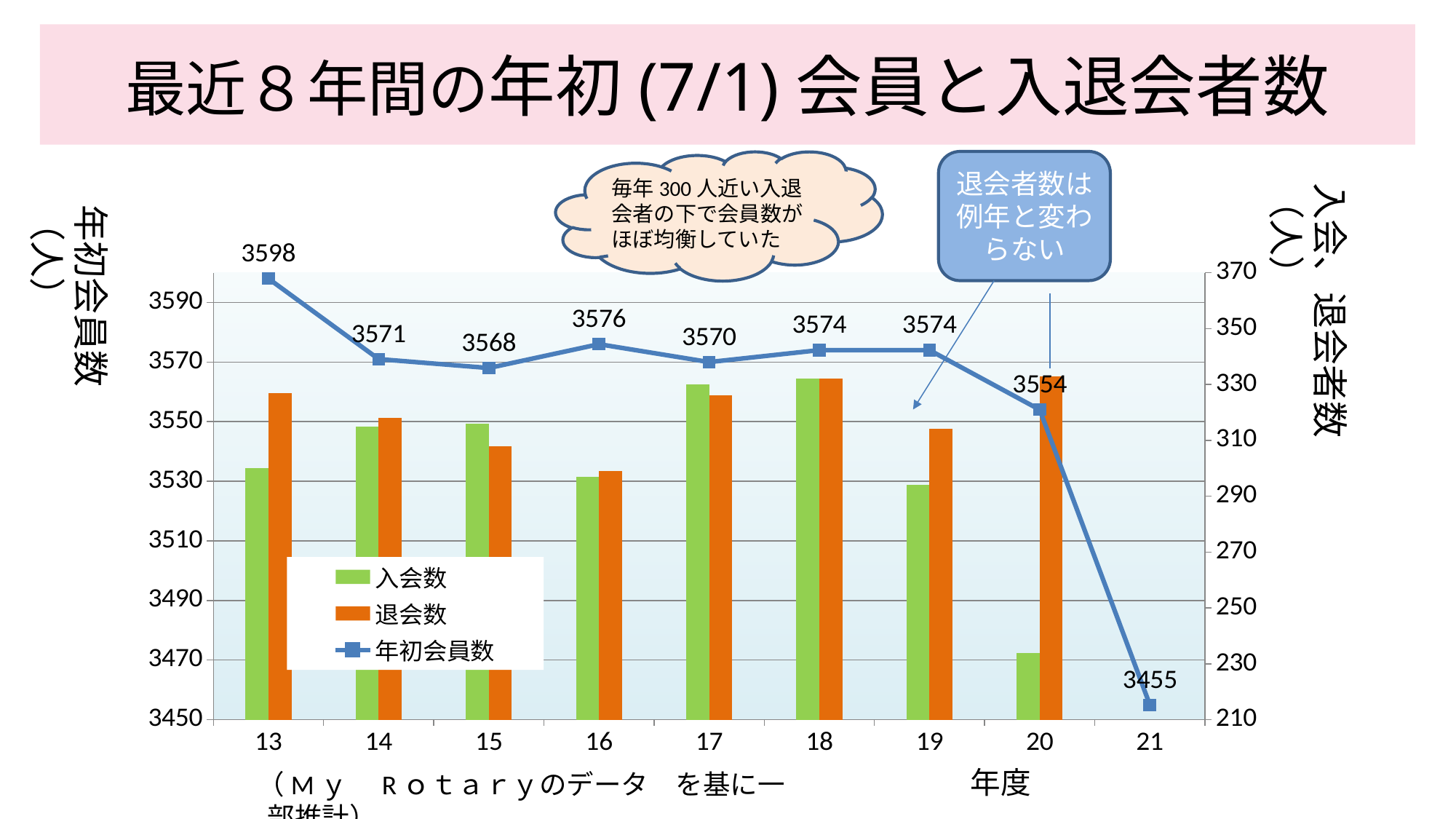
Which year has the lowest 年初会員数? 21 What is the difference in 年初会員数 between year 20 and year 21? 99 What kind of chart is this? Combined bar and line chart What is the 年初会員数 value for year 21? 3455 Is the 退会数 value for year 13 greater or less than 310? greater How many series does the legend list? 3 Which year has the highest 年初会員数? 13 How many years are shown on the x axis? 9 What is the 年初会員数 value for year 13? 3598 Which is larger, the 年初会員数 for year 16 or for year 15? year 16 What is the 年初会員数 value for year 20? 3554 Is the 入会数 value for year 20 greater or less than 250? less